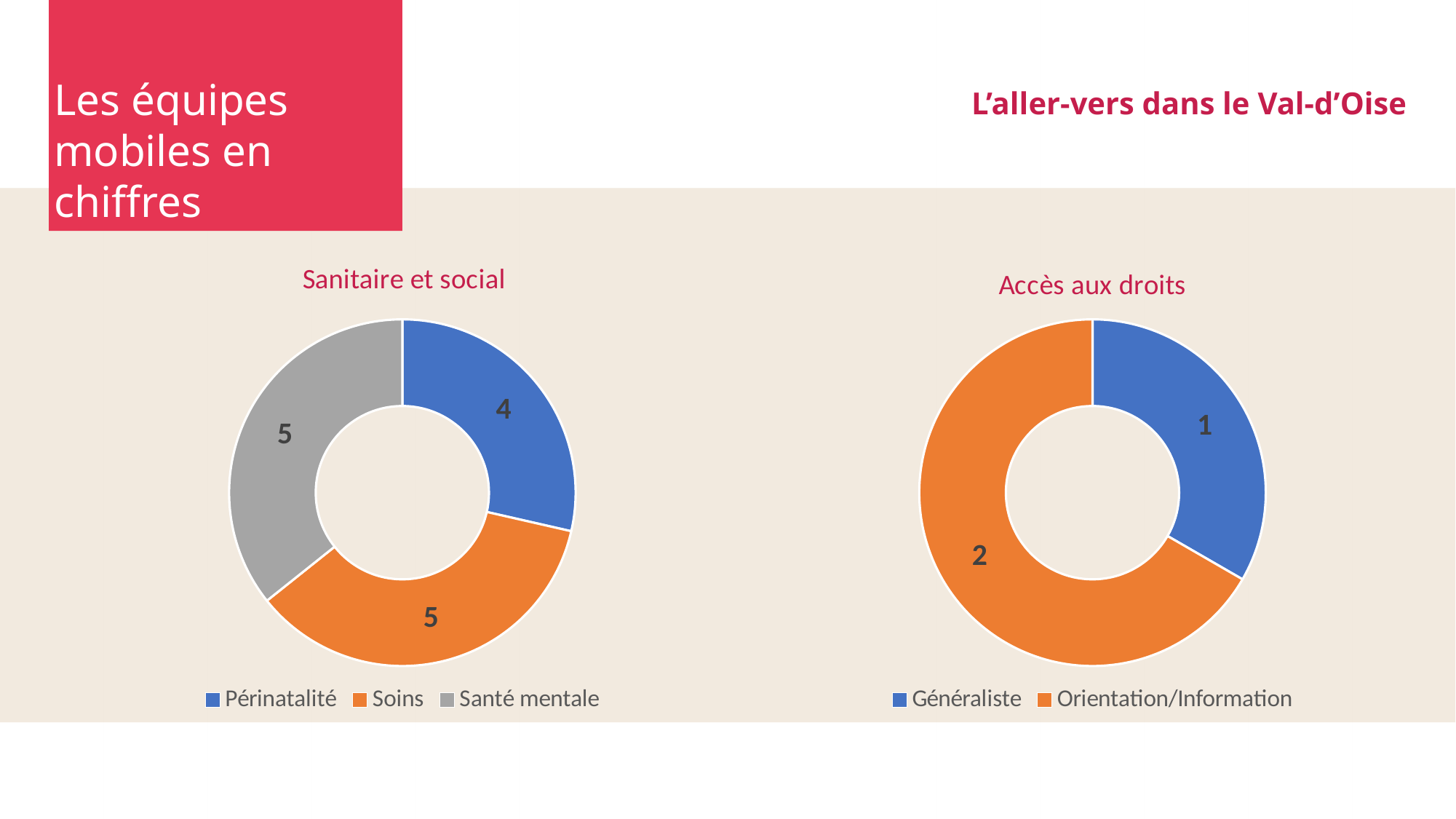
In the 'Sanitaire et social' chart, what is the value for Soins? 5 In the 'Sanitaire et social' chart, which category has the lowest value? Périnatalité In the 'Accès aux droits' chart, what is the value for Orientation/Information? 2 In the 'Accès aux droits' chart, which is larger: Généraliste or Orientation/Information? Orientation/Information In the 'Sanitaire et social' chart, what is the difference between the values for Soins and Périnatalité? 1 In the 'Accès aux droits' chart, what is the value for Généraliste? 1 In the 'Sanitaire et social' chart, what share of the total does Périnatalité represent? 4 out of 14 What kind of chart is the 'Accès aux droits' chart? Doughnut chart In the 'Sanitaire et social' chart, what is the value for Périnatalité? 4 How many categories does the 'Sanitaire et social' chart show? 3 In the 'Accès aux droits' chart, which category has the highest value? Orientation/Information How many categories does the 'Accès aux droits' chart show? 2